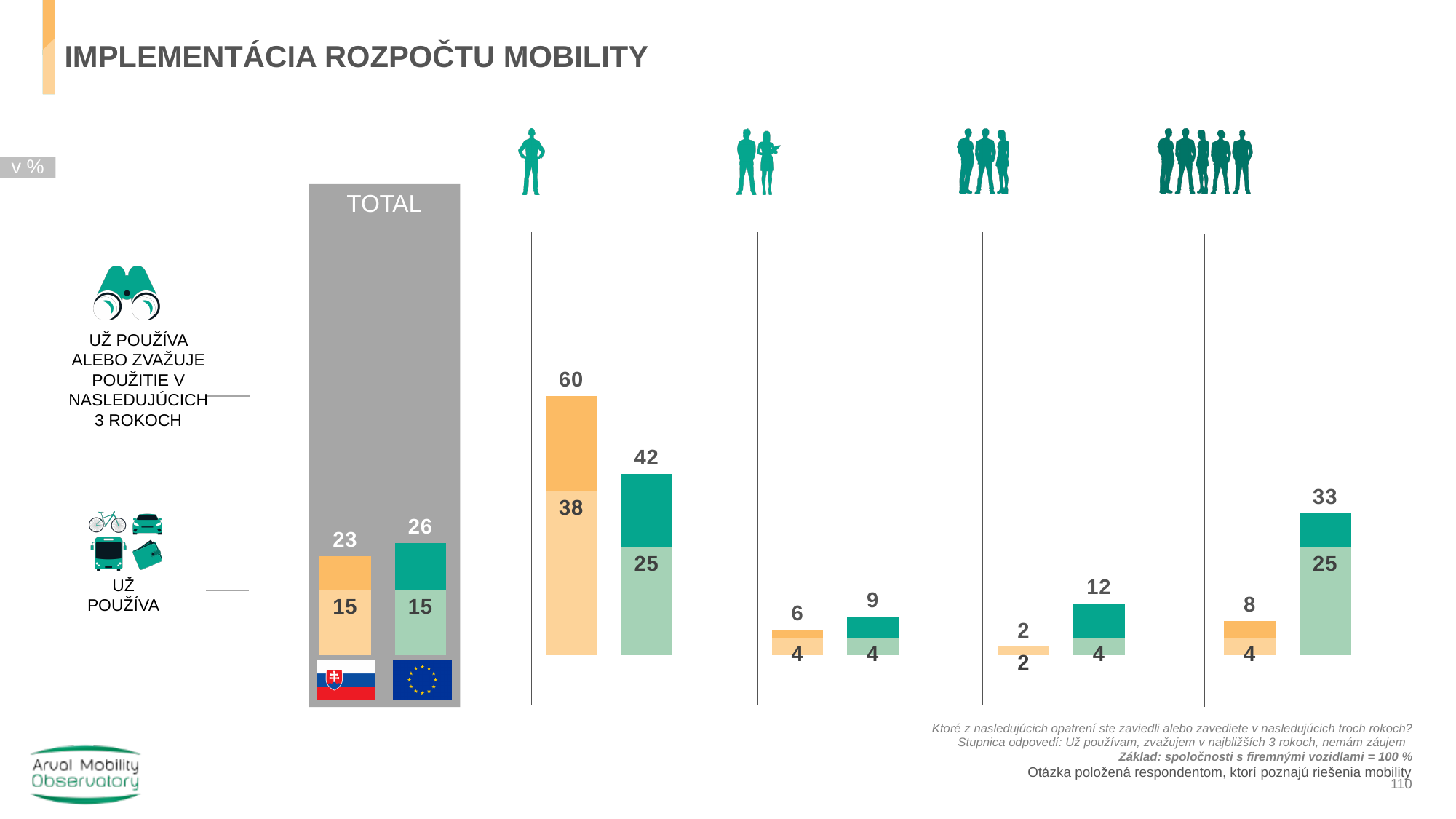
In the TOTAL section, what is the 'už používa' value for Slovakia? 15 In the third company-size group, what is the difference between the EU value (12) and the Slovakia value (2)? 10 In the first company-size group, which is larger: the Slovakia value or the EU value? Slovakia (60) How many company-size groups are shown to the right of the TOTAL section? 4 In the fourth company-size group, which is larger: the Slovakia value or the EU value? EU (33) Across the four company-size groups, which group has the highest Slovakia value? The first group (single-person icon), 60 In the TOTAL section, what is the value for Slovakia for 'už používa alebo zvažuje použitie v nasledujúcich 3 rokoch'? 23 In the first company-size group to the right of TOTAL (single-person icon), what is the top value of the Slovakia bar? 60 In the first company-size group to the right of TOTAL (single-person icon), what is the 'už používa' value for the EU? 25 In the fourth company-size group (largest group of people icons), what is the top value of the EU bar? 33 What type of chart is shown on the slide? Bar chart In the TOTAL section, what is the value for the EU for 'už používa alebo zvažuje použitie v nasledujúcich 3 rokoch'? 26